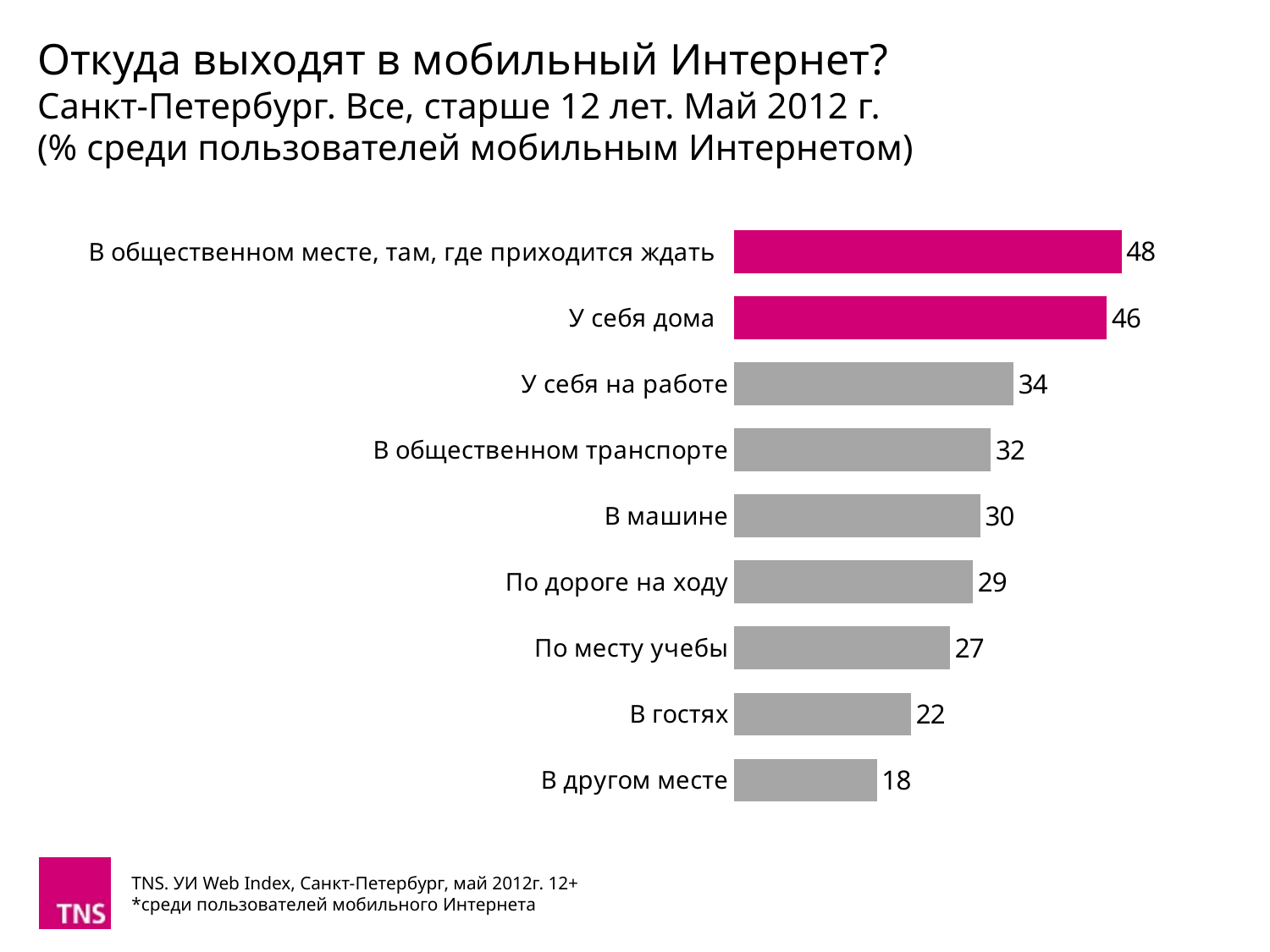
What is the value for «У себя дома»? 46 Which category has the lowest value? В другом месте What is the value for «В общественном транспорте»? 32 Which category has the highest value? В общественном месте, там, где приходится ждать What is the difference between the values for «У себя на работе» and «В гостях»? 12 Which is larger: the value for «В машине» or the value for «По дороге на ходу»? В машине What is the value for «В машине»? 30 What is the difference between the values for «В общественном месте, там, где приходится ждать» and «У себя дома»? 2 What is the value for «По месту учебы»? 27 How many bars are highlighted in magenta rather than grey? 2 How many categories are shown in the chart? 9 What kind of chart is shown on the slide? Bar chart